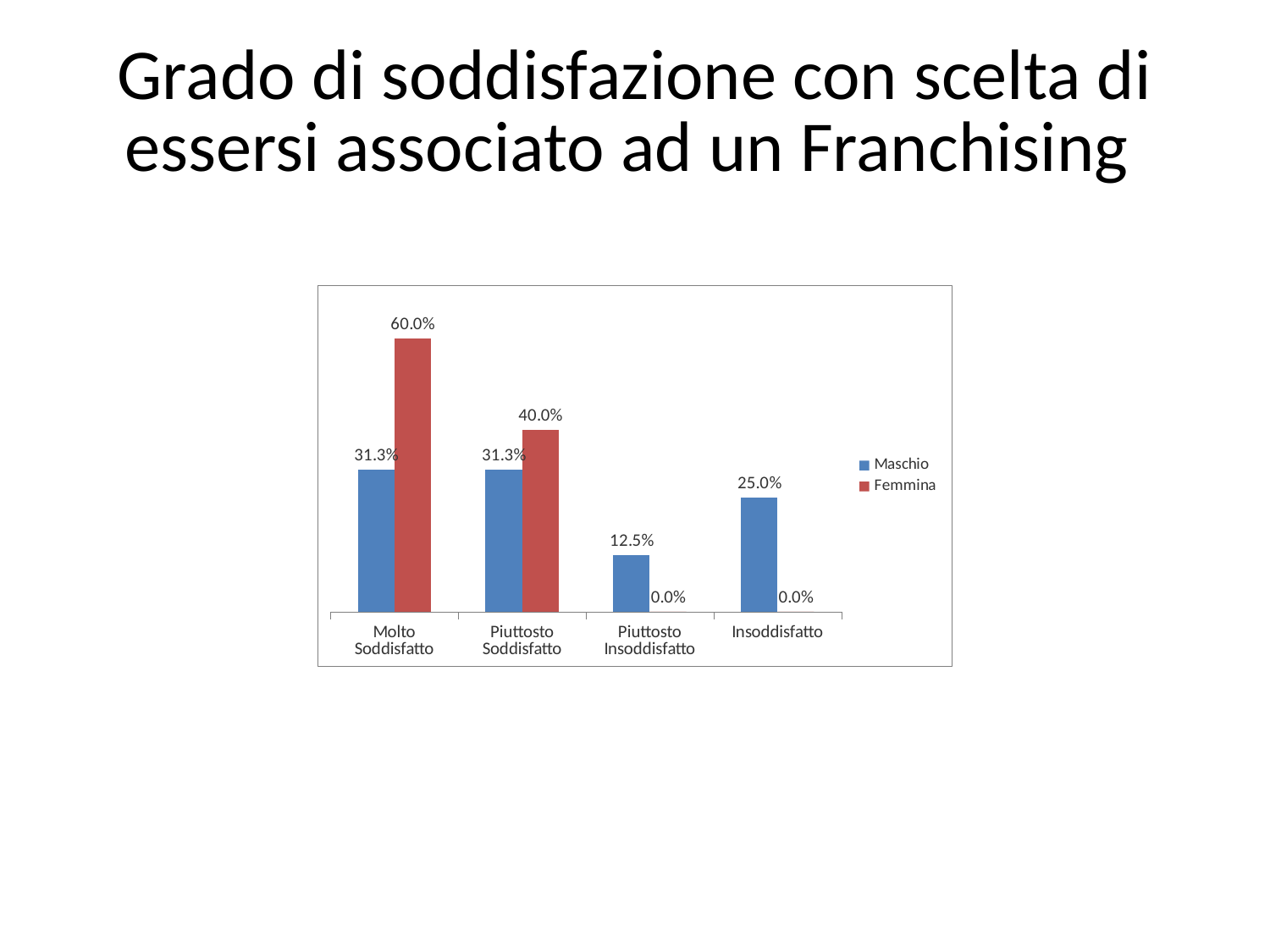
Which category has the highest Femmina value? Molto Soddisfatto Which is larger for Piuttosto Soddisfatto, the Maschio value or the Femmina value? Femmina How many categories are shown on the x axis? 4 Which series is shown in red in the legend? Femmina What is the Femmina value for Piuttosto Soddisfatto? 40.0% What is the Maschio value for Piuttosto Insoddisfatto? 12.5% What is the difference between the Femmina and Maschio values for Molto Soddisfatto? 28.7% What is the Femmina value for Molto Soddisfatto? 60.0% What is the Maschio value for Insoddisfatto? 25.0% What kind of chart is shown on the slide? Bar chart How many series does the legend list? 2 Which category has the lowest Maschio value? Piuttosto Insoddisfatto